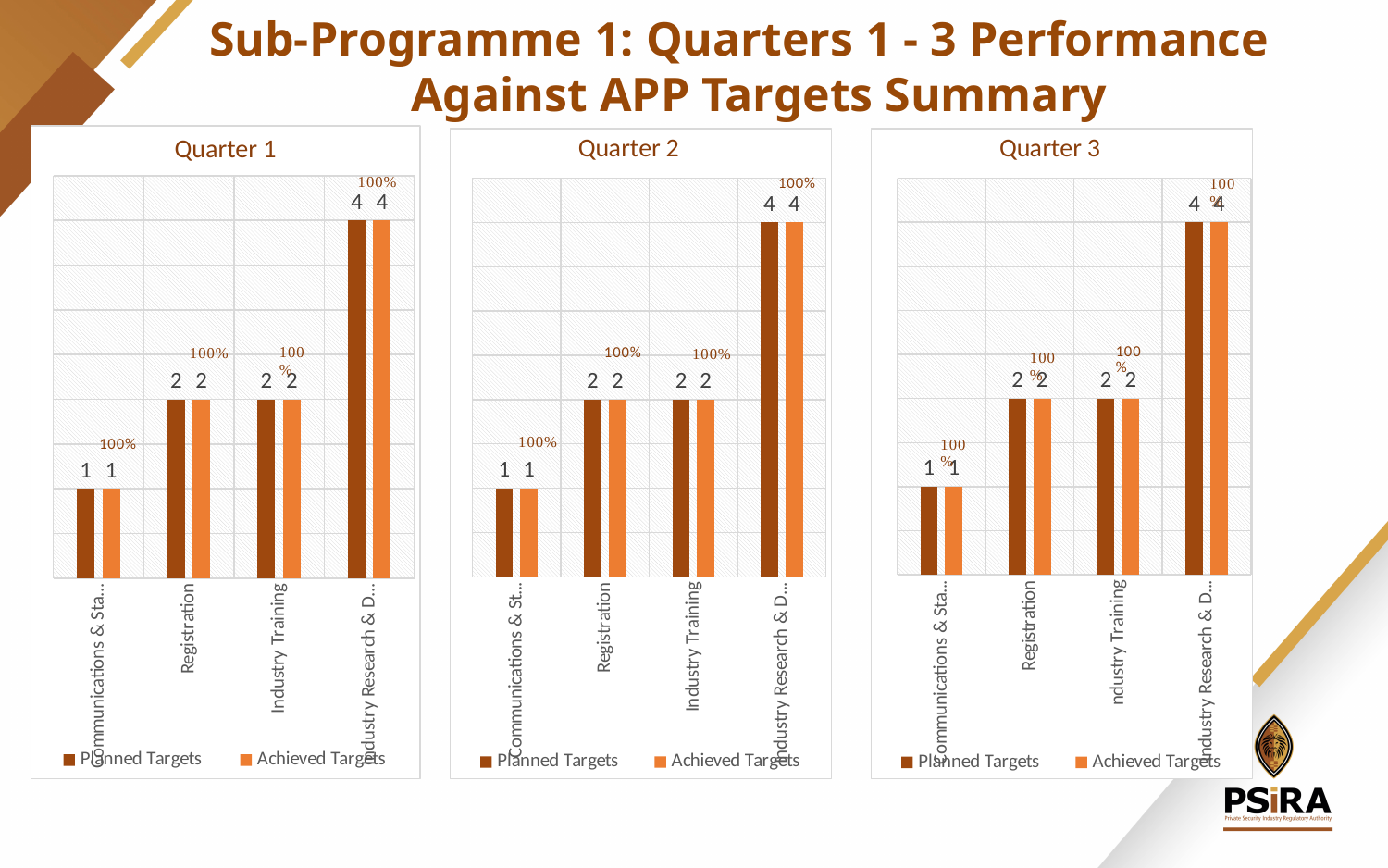
In the Quarter 1 chart, which category has the highest Planned Targets value? Industry Research & D... How many series does the legend of the Quarter 3 chart list? 2 In the Quarter 1 chart, is the Planned Targets value for Registration larger than, smaller than, or equal to the Planned Targets value for Industry Training? equal In the Quarter 3 chart, what is the Planned Targets value for Registration? 2 What kind of chart is the Quarter 1 chart? bar chart How many categories are shown on the x axis of the Quarter 2 chart? 4 What are the two legend entries in the Quarter 1 chart? Planned Targets, Achieved Targets In the Quarter 3 chart, what is the difference between the Planned Targets values for Industry Research & D... and Registration? 2 What percentage label is shown above the Registration bars in the Quarter 2 chart? 100% In the Quarter 1 chart, what is the Planned Targets value for Registration? 2 In the Quarter 2 chart, which category has the lowest Achieved Targets value? Communications & St... In the Quarter 2 chart, what is the Achieved Targets value for Industry Training? 2